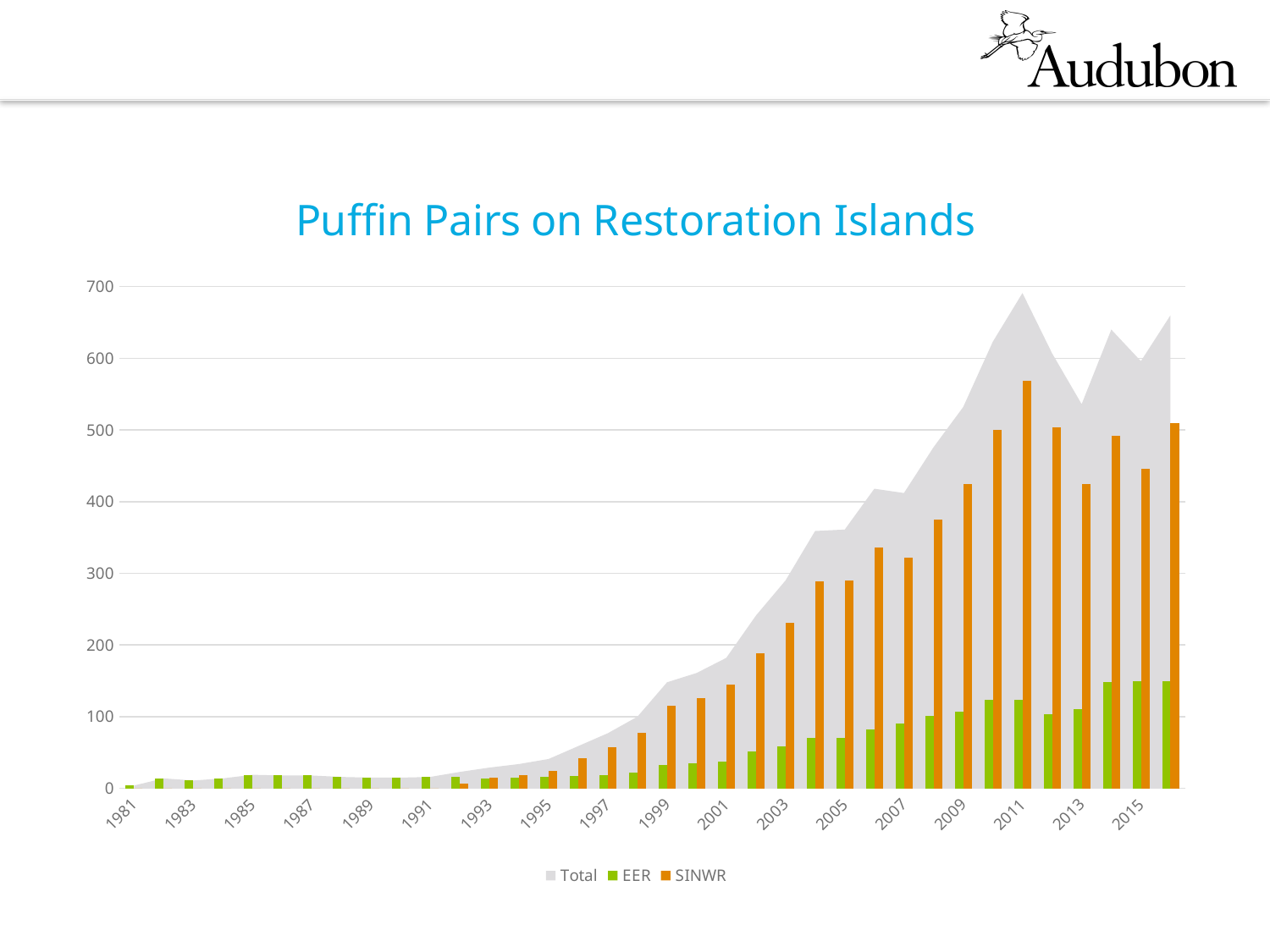
How many series does the legend list? 3 Is the Total value for 2011 greater or less than 600? greater Is the SINWR value for 2011 greater or less than 500? greater In which year is the SINWR bar highest? 2011 Is the EER value for 2015 greater or less than 100? greater What are the names of the series in the legend? Total, EER, SINWR Does the Total series generally rise or fall from 1981 to 2011? rise What is the title of the chart? Puffin Pairs on Restoration Islands In 2011, which series has the larger value, EER or SINWR? SINWR